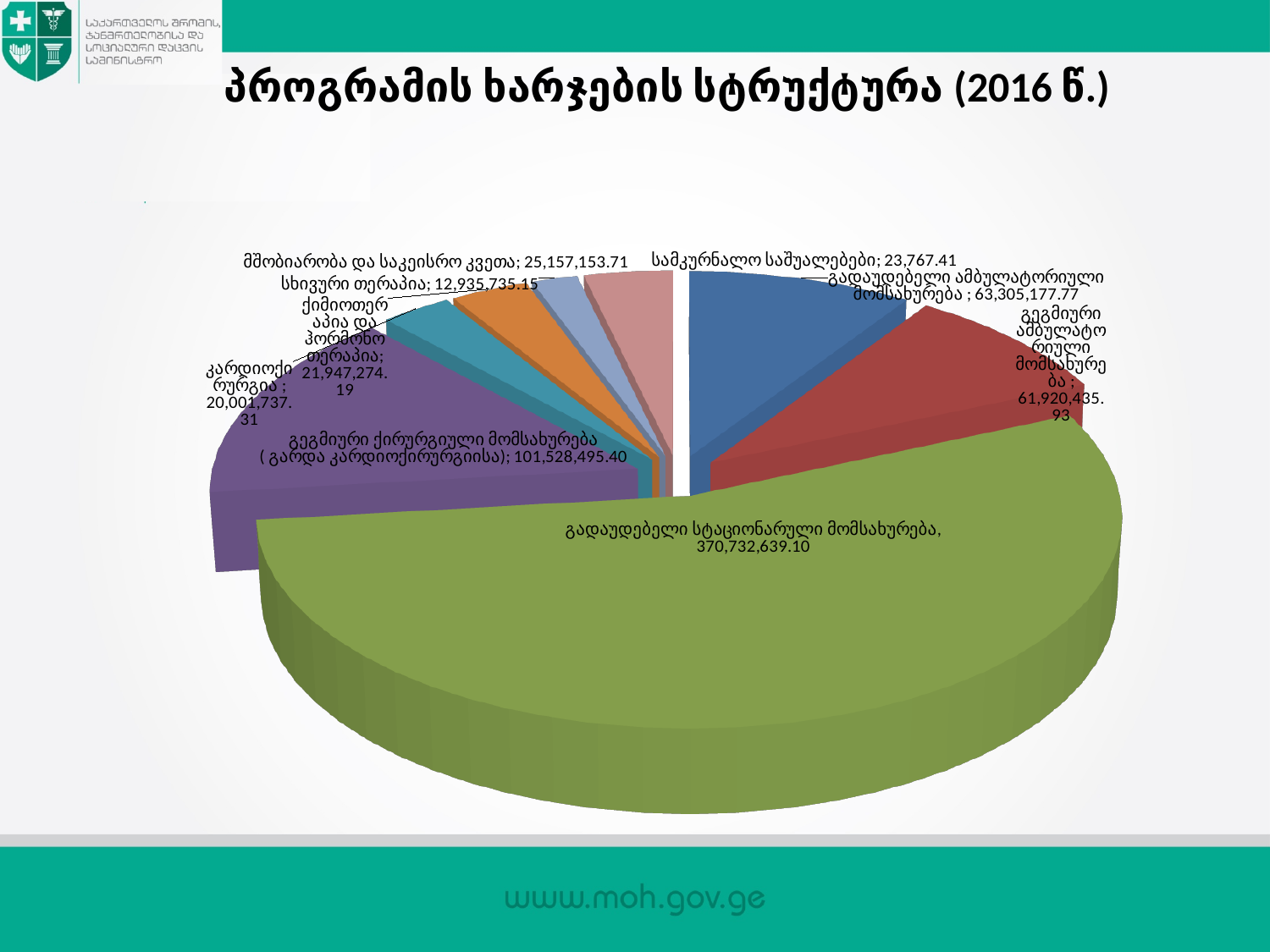
Which is larger: გადაუდებელი ამბულატორიული მომსახურება or გეგმიური ამბულატორიული მომსახურება? გადაუდებელი ამბულატორიული მომსახურება Which category has the smallest value? სამკურნალო საშუალებები What is the title of the chart on the slide? პროგრამის ხარჯების სტრუქტურა (2016 წ.) Which category has the largest slice of the pie? გადაუდებელი სტაციონარული მომსახურება What is the value for სხივური თერაპია? 12,935,735.15 How many slices does the pie chart have? 9 What is the value for კარდიოქირურგია? 20,001,737.31 What is the value for სამკურნალო საშუალებები? 23,767.41 What is the value for გეგმიური ქირურგიული მომსახურება (გარდა კარდიოქირურგიისა)? 101,528,495.40 What is the difference between მშობიარობა და საკეისრო კვეთა and სხივური თერაპია? 12,221,418.56 What is the value for გადაუდებელი სტაციონარული მომსახურება? 370,732,639.10 What kind of chart is shown on the slide? pie chart